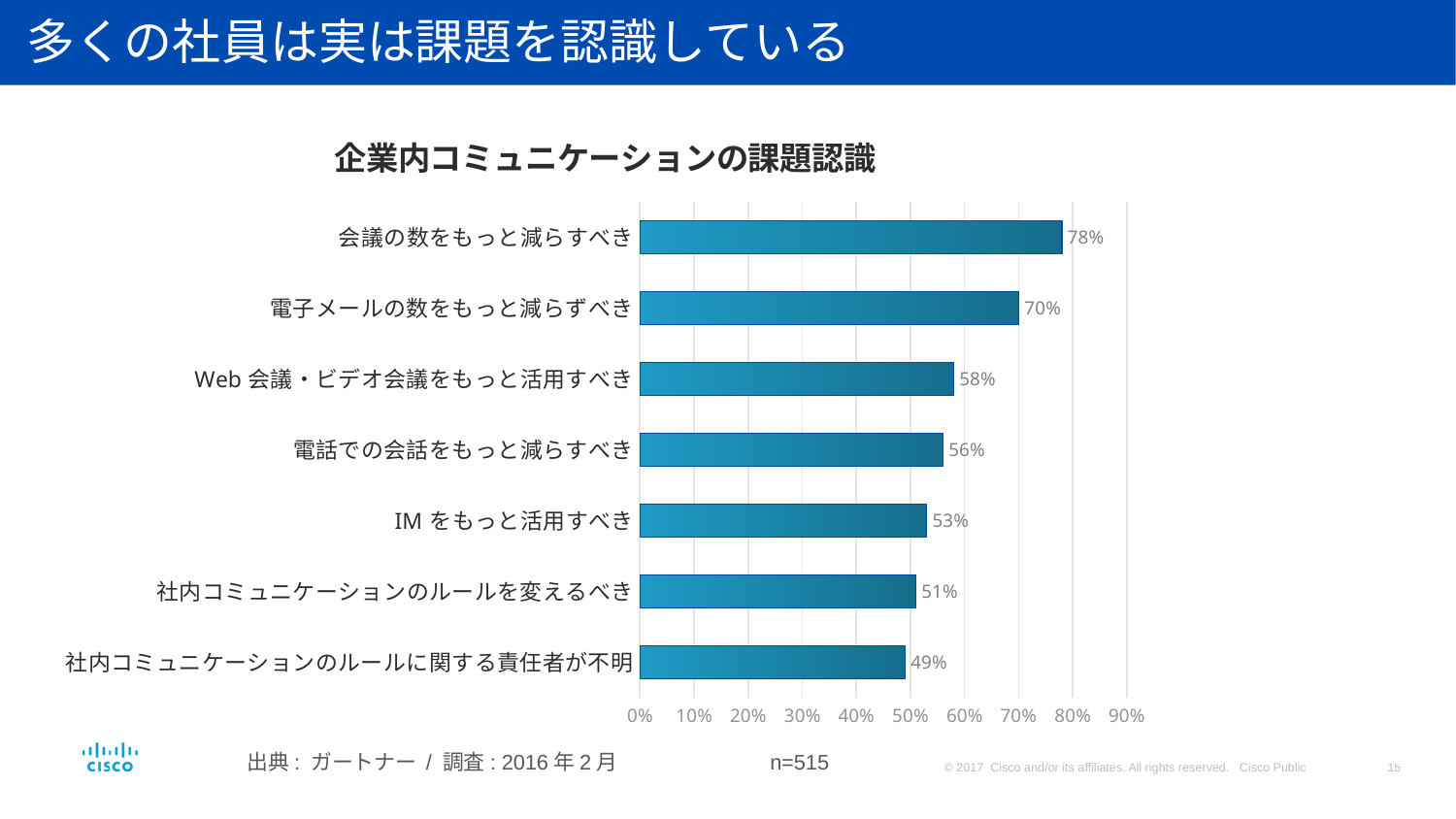
Which category has the lowest value? 社内コミュニケーションのルールに関する責任者が不明 What is the value for 会議の数をもっと減らすべき? 78% What is the sample size (n) shown on the slide? n=515 Which category has the highest value? 会議の数をもっと減らすべき What kind of chart is shown on the slide? bar chart What is the difference between 会議の数をもっと減らすべき and 電子メールの数をもっと減らずべき? 8% How many categories are shown in the chart? 7 What is the value for 社内コミュニケーションのルールに関する責任者が不明? 49% What is the title of the chart? 企業内コミュニケーションの課題認識 Is the value for 社内コミュニケーションのルールを変えるべき greater or less than 60%? less Which is larger, Web 会議・ビデオ会議をもっと活用すべき or 電話での会話をもっと減らすべき? Web 会議・ビデオ会議をもっと活用すべき What is the value for IM をもっと活用すべき? 53%